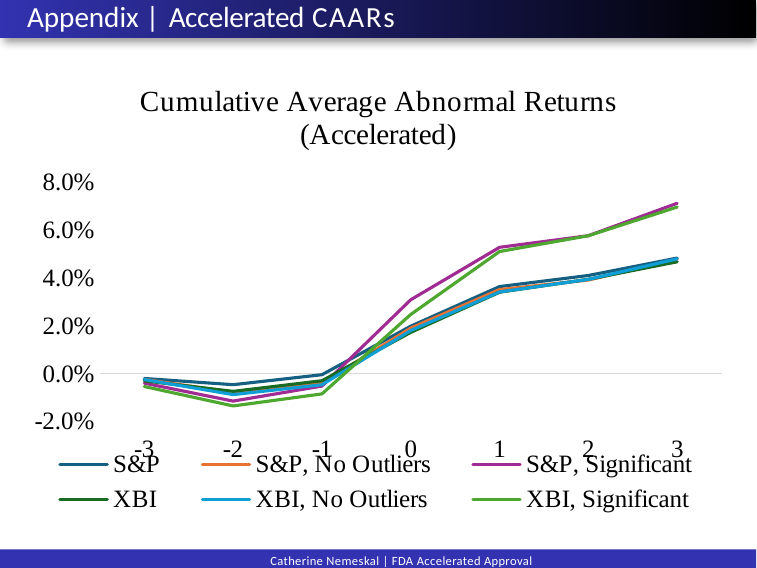
Do the values for S&P, Significant rise or fall from day 0 to day 3? rise How many series does the legend list? 6 What kind of chart is shown on the slide? line chart Is the value for S&P, Significant at day 3 greater or less than 6.0%? greater At day -2, which is larger: the value for S&P or the value for S&P, Significant? S&P How many points are plotted along the x axis (from -3 to 3)? 7 At day 3, which is larger: the value for S&P, Significant or the value for S&P? S&P, Significant Is the value for S&P, Significant at day -2 greater or less than 0.0%? less Which series is drawn in purple according to the legend? S&P, Significant Is the value for XBI at day 3 greater or less than 6.0%? less What is the title of the chart? Cumulative Average Abnormal Returns (Accelerated) Do the values for XBI rise or fall from day -3 to day -2? fall